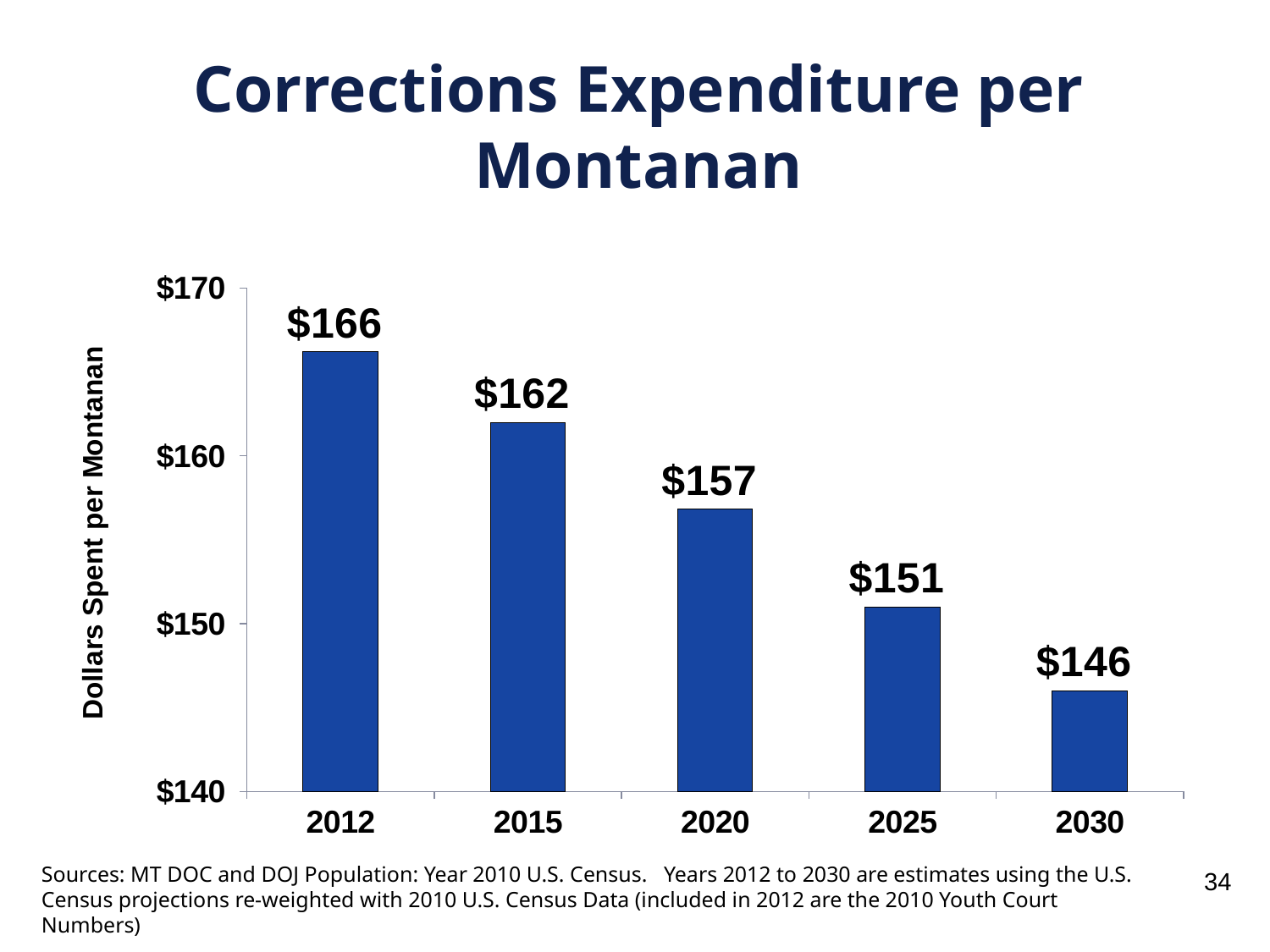
Which is larger, the expenditure per Montanan in 2015 or in 2025? 2015 Do the values rise or fall from 2012 to 2030? fall How many years are shown on the x axis? 5 Is the value for 2025 greater or less than $160? less What is the difference between the expenditure per Montanan in 2015 and in 2025? $11 What kind of chart is shown on the slide? bar chart What is the corrections expenditure per Montanan in 2012? $166 What is the corrections expenditure per Montanan in 2030? $146 Which year has the highest corrections expenditure per Montanan? 2012 Which year has the lowest corrections expenditure per Montanan? 2030 What is the difference between the expenditure per Montanan in 2012 and in 2030? $20 What is the corrections expenditure per Montanan in 2020? $157